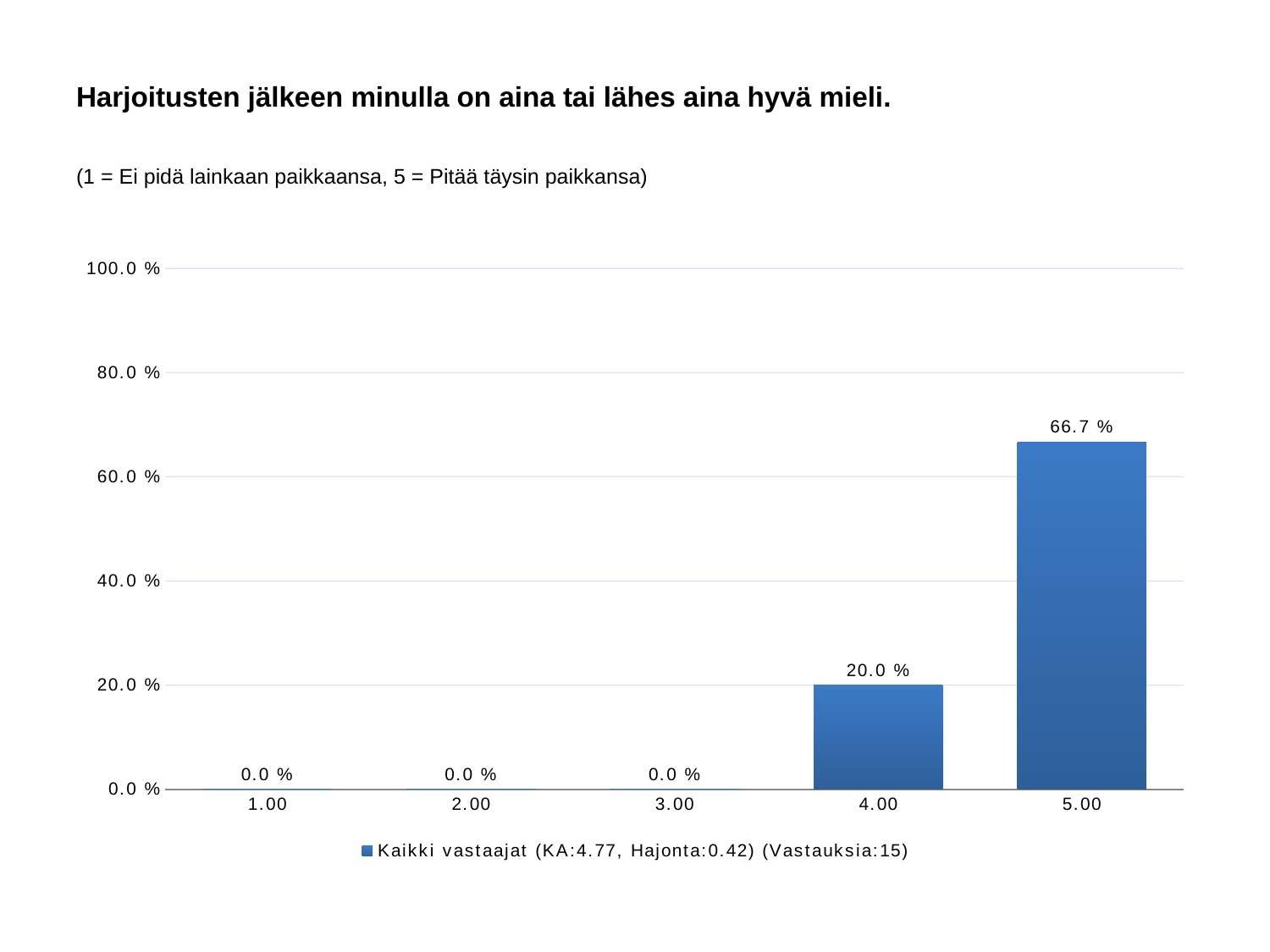
How many series does the legend list? 1 What kind of chart is shown? bar chart What is the value for category 5.00? 66.7 % What is the legend entry for the series? Kaikki vastaajat (KA:4.77, Hajonta:0.42) (Vastauksia:15) What is the difference between the values for 5.00 and 4.00? 46.7 % Which category has the highest value? 5.00 Is the value for 5.00 greater or less than 60.0 %? greater Which is larger, the value for 4.00 or the value for 5.00? 5.00 What is the value for category 4.00? 20.0 % How many categories are shown on the x axis? 5 How many categories have a value of 0.0 %? 3 What is the value for category 1.00? 0.0 %